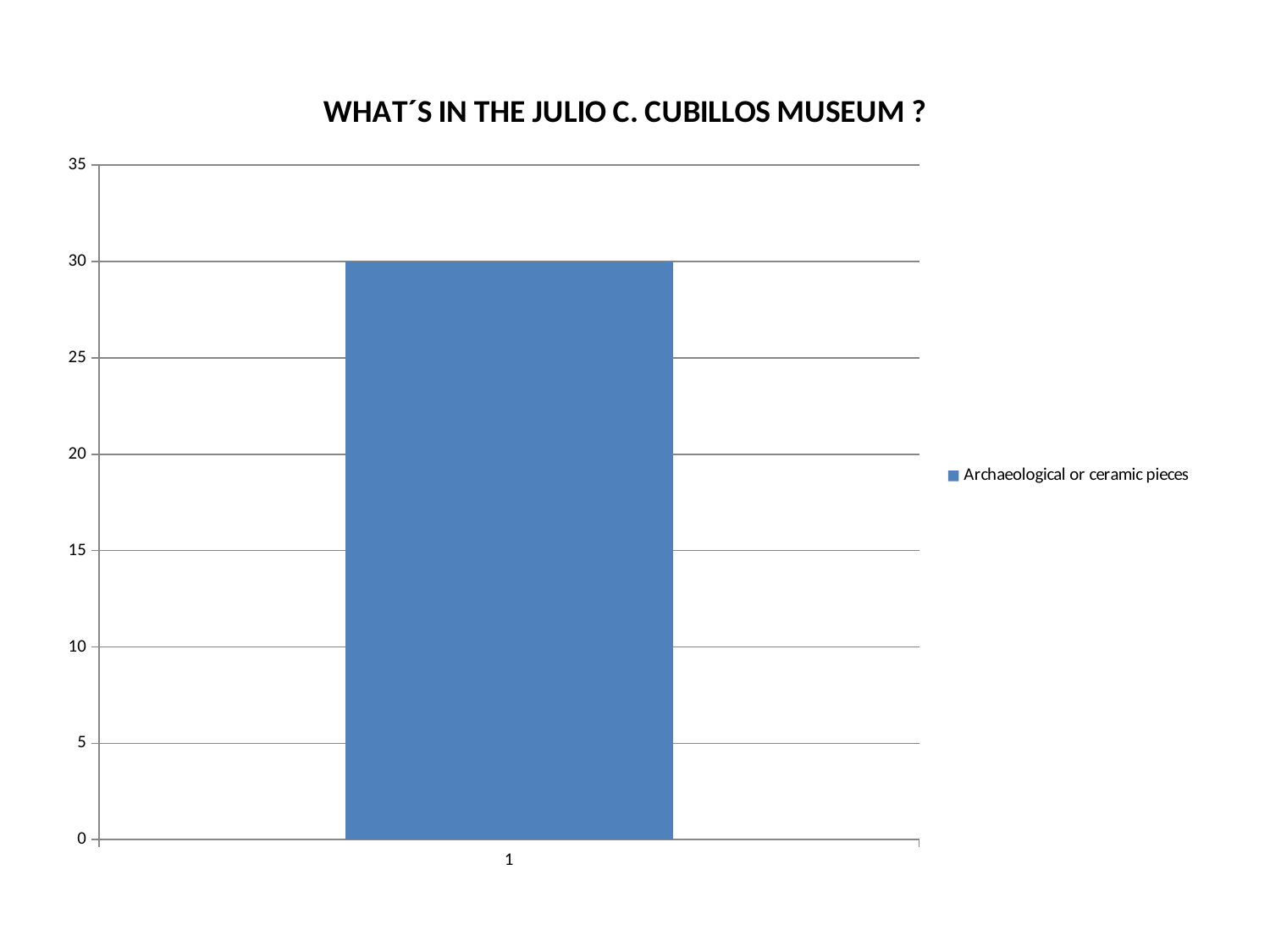
What is the highest value shown on the vertical axis? 35 Is the value for Archaeological or ceramic pieces greater or less than 35? less What is the category label shown on the horizontal axis? 1 What series name is shown in the legend? Archaeological or ceramic pieces What kind of chart is shown on the slide? bar chart What is the title of the chart? WHAT´S IN THE JULIO C. CUBILLOS MUSEUM ? Is the value for Archaeological or ceramic pieces greater or less than 20? greater Is the value for Archaeological or ceramic pieces greater or less than 25? greater What is the value of the bar for Archaeological or ceramic pieces? 30 How many bars are plotted in the chart? 1 How many series does the legend list? 1